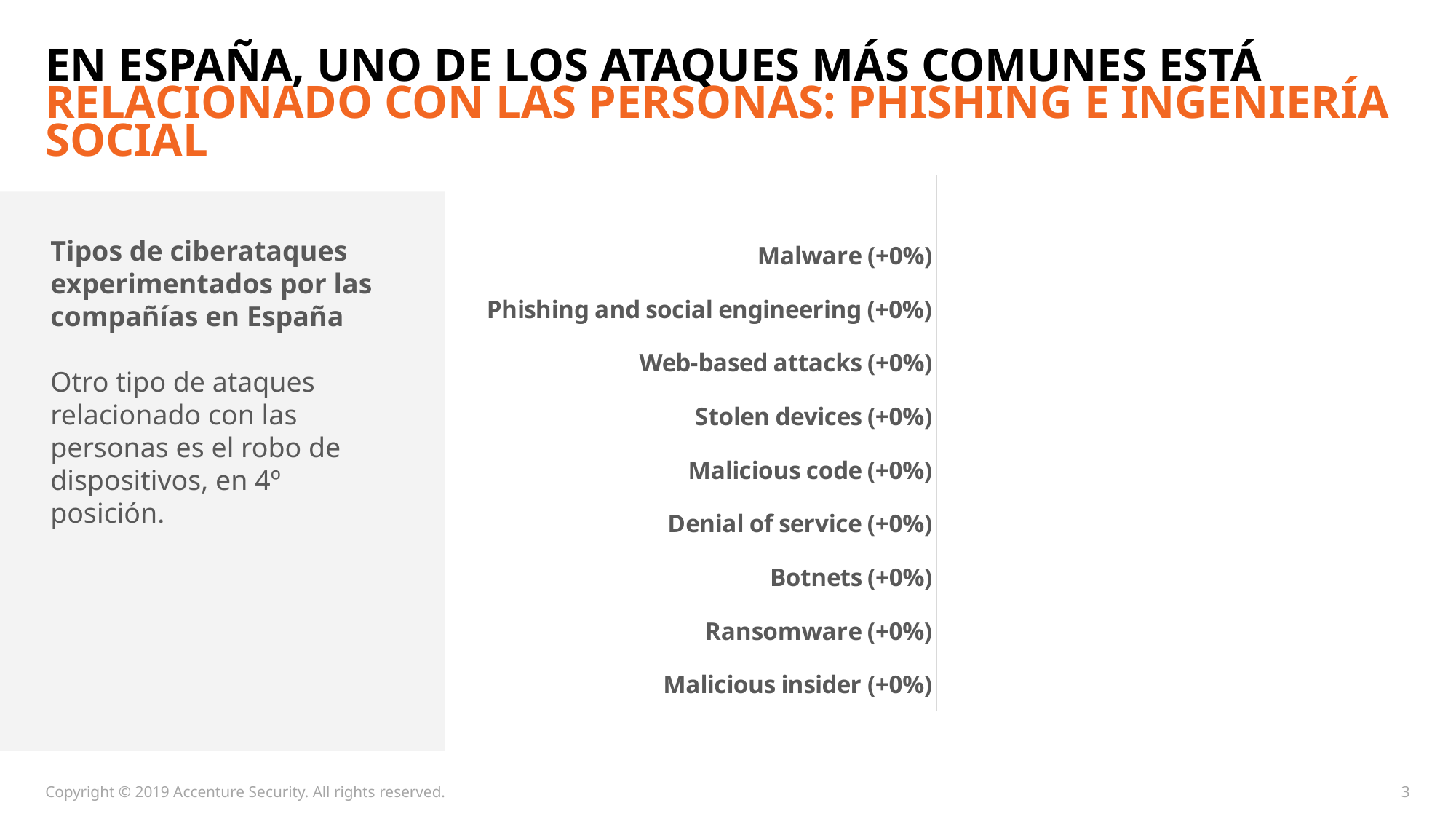
How many categories are listed on the chart's axis? 9 What percentage change is shown in parentheses next to the Phishing and social engineering category label? +0% What percentage change is shown in parentheses next to the Stolen devices category label? +0% Which category is listed last (at the bottom) of the chart? Malicious insider (+0%) Which category appears in the fourth position from the top of the chart? Stolen devices (+0%) Which category is listed first (at the top) of the chart? Malware (+0%)